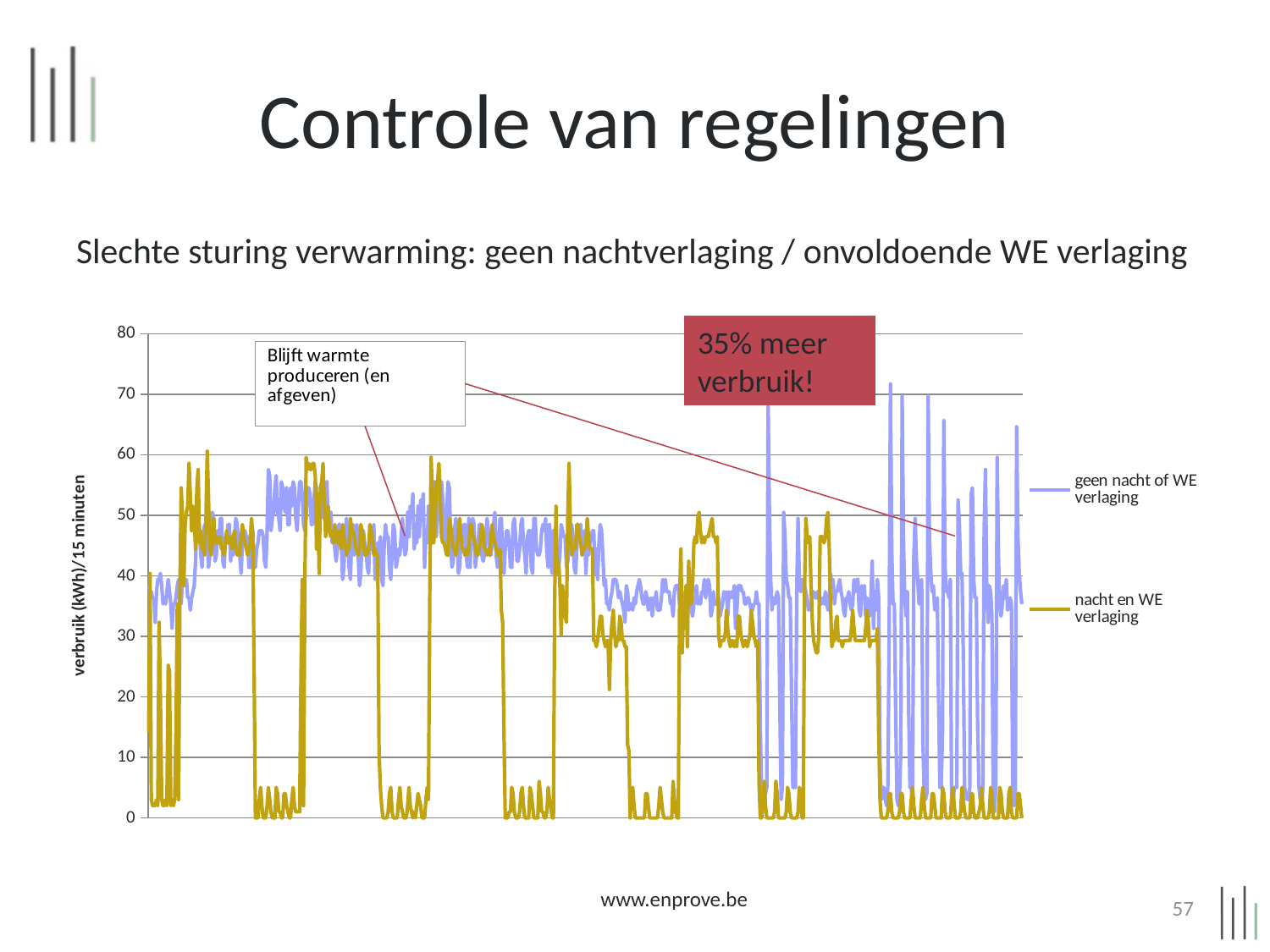
How many series does the chart's legend list? 2 What is the highest value shown on the chart's vertical axis? 80 Is the lowest value of the 'geen nacht of WE verlaging' series in the first half of the chart greater or less than 20? greater Is the highest peak of the 'geen nacht of WE verlaging' series greater or less than 60? greater What is the label of the chart's vertical axis? verbruik (kWh)/15 minuten During its low periods, does the 'nacht en WE verlaging' series fall to values greater or less than 10? less What kind of chart is shown on the slide? line chart Which legend entry corresponds to the gold (yellow) line? nacht en WE verlaging